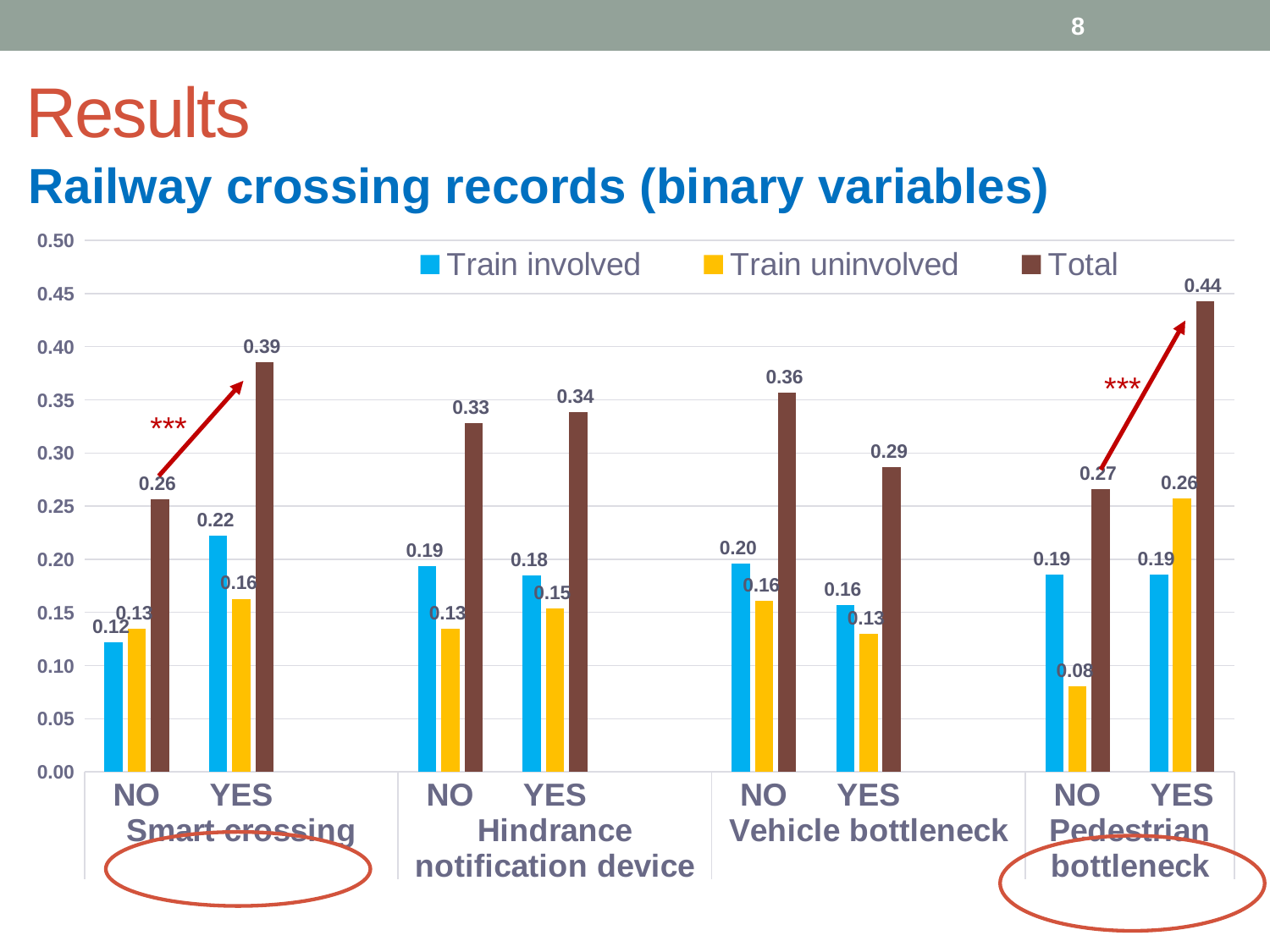
What is the Total value for Hindrance notification device YES? 0.34 What is the Train involved value for Vehicle bottleneck NO? 0.20 What kind of chart is shown on the slide? Bar chart Which is larger, the Total value for Vehicle bottleneck NO or for Vehicle bottleneck YES? Vehicle bottleneck NO What is the difference between the Total values for Smart crossing YES and Smart crossing NO? 0.13 Which category has the highest Total value? Pedestrian bottleneck YES Which category has the lowest Train uninvolved value? Pedestrian bottleneck NO Is the Total value for Pedestrian bottleneck YES greater or less than 0.40? greater What is the Total value for Smart crossing YES? 0.39 What is the Train uninvolved value for Pedestrian bottleneck NO? 0.08 How many series does the legend list? 3 What is the title of the chart? Railway crossing records (binary variables)